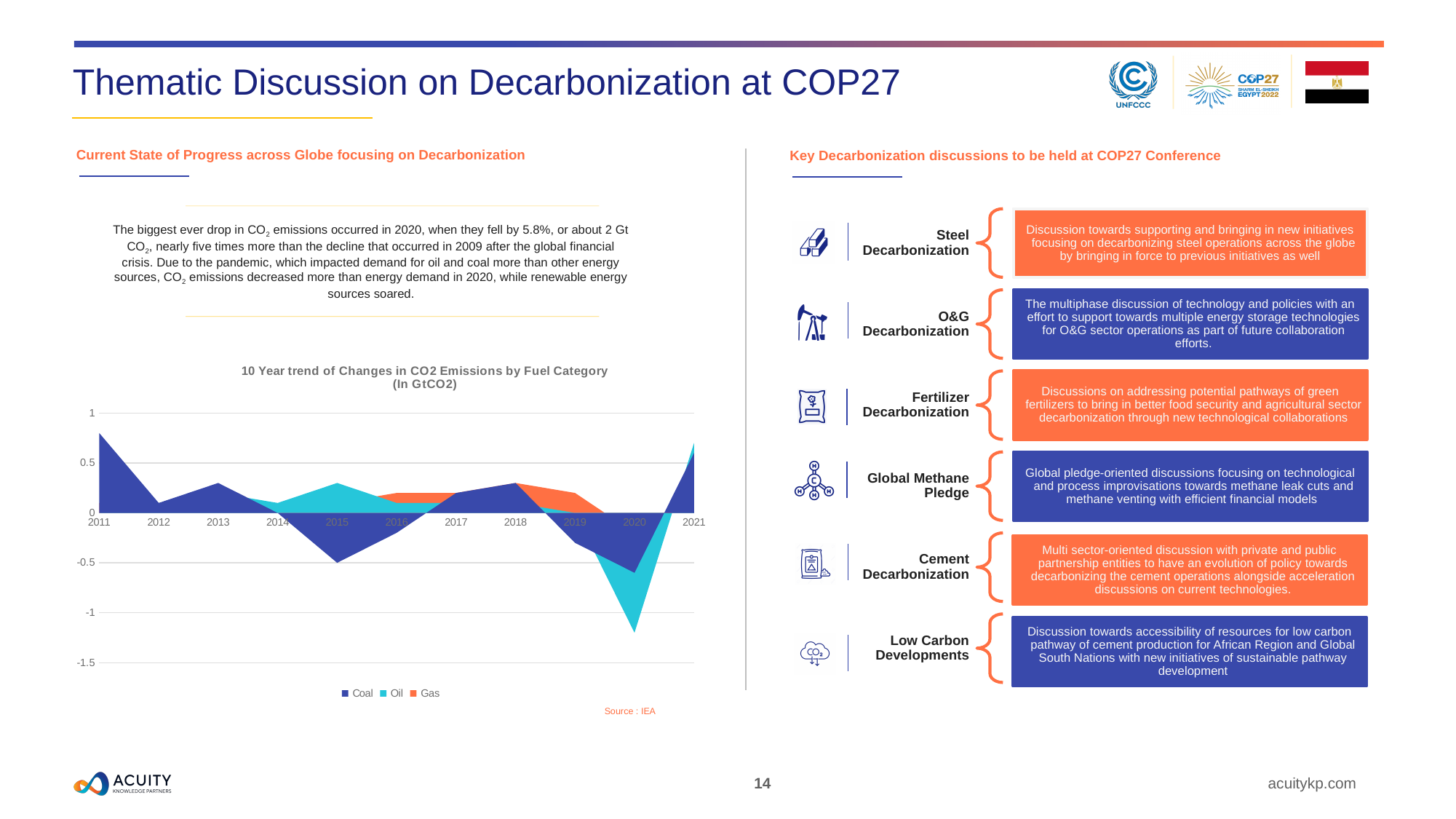
What is the first year shown on the x axis of the CO2 emissions chart? 2011 How many series does the legend of the CO2 emissions chart list? 3 What is the unit stated in the title of the CO2 emissions chart? GtCO2 Is the value for Oil in 2020 greater or less than -1 on the CO2 emissions chart? less Is the value for Coal in 2011 greater or less than 0.5 on the CO2 emissions chart? greater Is the value for Oil in 2021 greater or less than 0.5 on the CO2 emissions chart? greater In which year does the Coal series reach its highest value on the CO2 emissions chart? 2011 Which series reaches the lowest value anywhere on the CO2 emissions chart? Oil Which series are listed in the legend of the CO2 emissions chart? Coal, Oil, Gas What type of chart is shown under the title '10 Year trend of Changes in CO2 Emissions by Fuel Category'? Area chart How many years are shown on the x axis of the CO2 emissions chart? 11 In which year does the Oil series reach its lowest value on the CO2 emissions chart? 2020